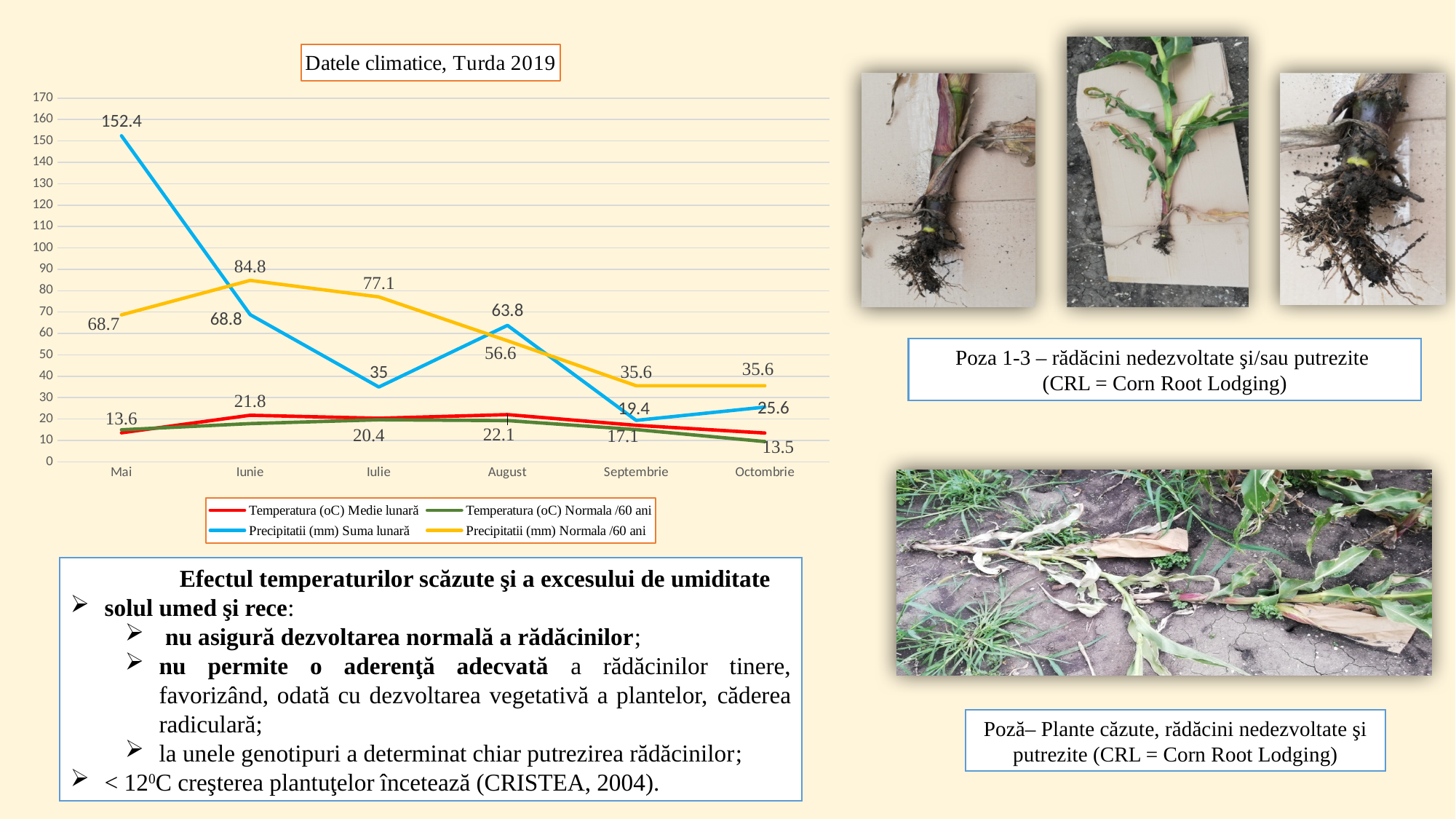
How many series does the legend of the 'Datele climatice, Turda 2019' chart list? 4 Does 'Precipitatii (mm) Normala /60 ani' rise or fall from Iunie to Septembrie? fall What is the difference between 'Precipitatii (mm) Suma lunară' and 'Precipitatii (mm) Normala /60 ani' in Mai? 83.7 In which month is 'Precipitatii (mm) Suma lunară' highest? Mai Is the value of 'Precipitatii (mm) Suma lunară' for Mai greater or less than 100? greater What is the value of 'Precipitatii (mm) Normala /60 ani' for Octombrie? 35.6 What is the value of 'Precipitatii (mm) Suma lunară' for Mai? 152.4 What is the value of 'Precipitatii (mm) Normala /60 ani' for Iunie? 84.8 How many months are shown on the x axis of the 'Datele climatice, Turda 2019' chart? 6 In Iulie, which is larger: 'Precipitatii (mm) Suma lunară' or 'Precipitatii (mm) Normala /60 ani'? Precipitatii (mm) Normala /60 ani In which month is 'Precipitatii (mm) Suma lunară' lowest? Septembrie What kind of chart is shown under the title 'Datele climatice, Turda 2019'? line chart